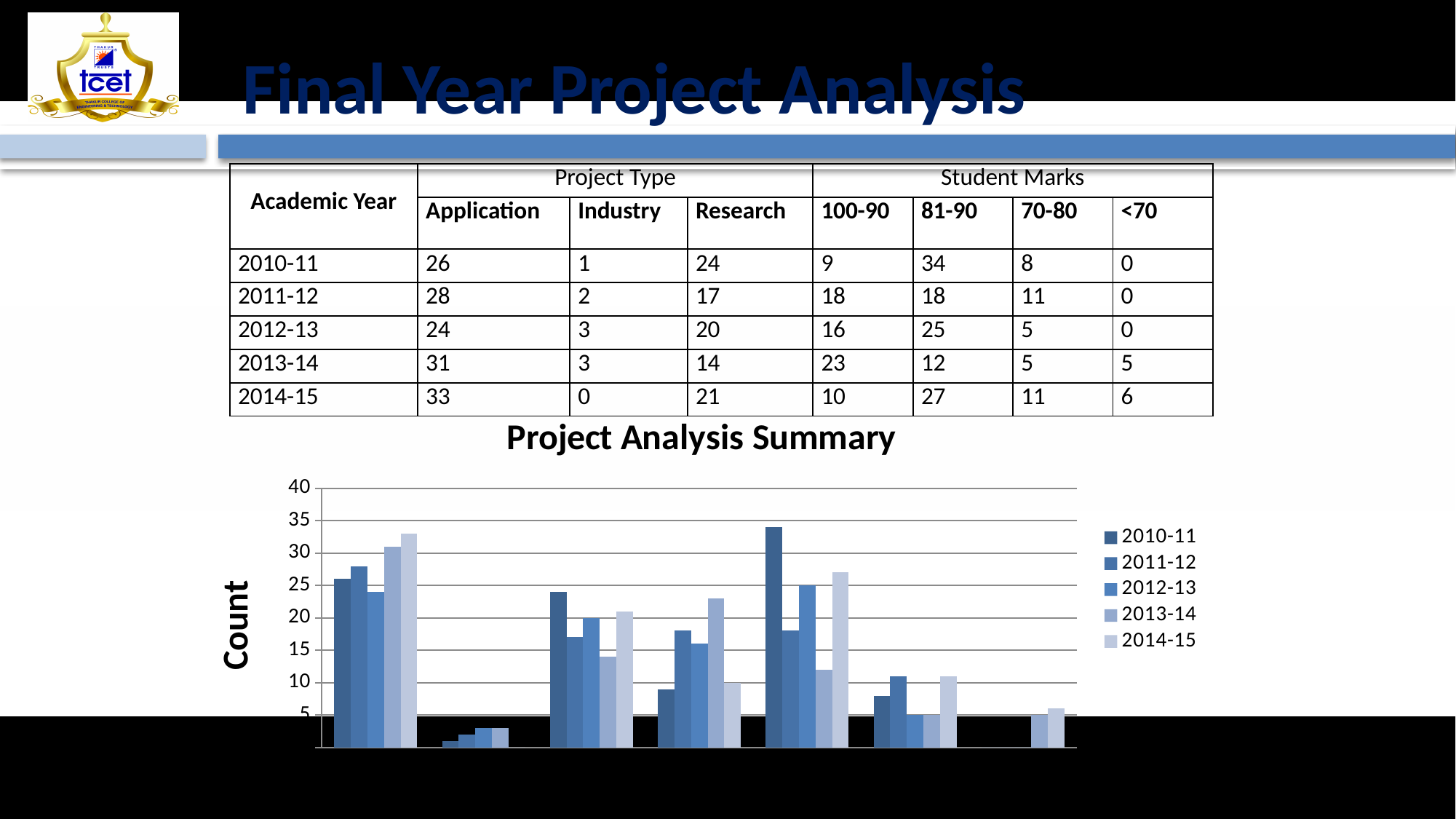
What kind of chart is the Project Analysis Summary chart? bar chart In the Project Analysis Summary chart, is the 2014-15 bar in the fourth group greater or less than 20? less What is the label on the vertical axis of the Project Analysis Summary chart? Count In the Project Analysis Summary chart, is the 2013-14 bar in the fifth group greater or less than 15? less In the Project Analysis Summary chart, is the 2010-11 bar in the fifth group greater or less than 30? greater In the Project Analysis Summary chart, which is larger in the fifth group: the 2010-11 bar or the 2013-14 bar? 2010-11 How many groups of bars are plotted in the Project Analysis Summary chart? 7 How many series does the legend of the Project Analysis Summary chart list? 5 What is the title of the chart on the slide? Project Analysis Summary